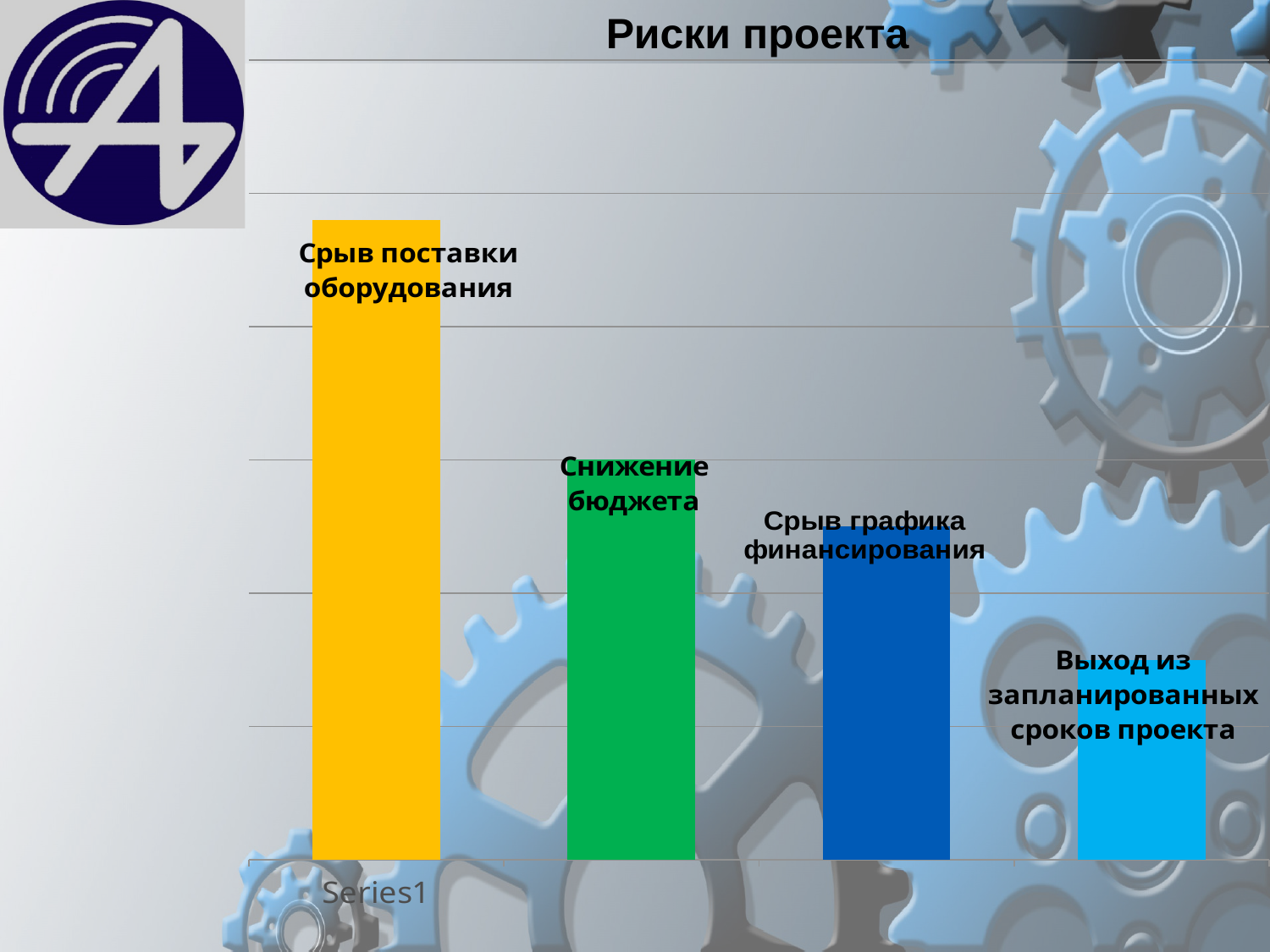
Do the bar heights rise or fall from left to right across the chart? fall What colour is the bar for Срыв поставки оборудования? yellow Which risk has the shortest bar in the chart? Выход из запланированных сроков проекта Which bar is taller: Срыв графика финансирования or Выход из запланированных сроков проекта? Срыв графика финансирования How many bars does the chart contain? 4 Which bar is taller: Выход из запланированных сроков проекта or Срыв поставки оборудования? Срыв поставки оборудования Which risk has the tallest bar in the chart? Срыв поставки оборудования Which bar is taller: Снижение бюджета or Срыв графика финансирования? Снижение бюджета What is the title of the slide containing the chart? Риски проекта What kind of chart is shown on the slide? bar chart